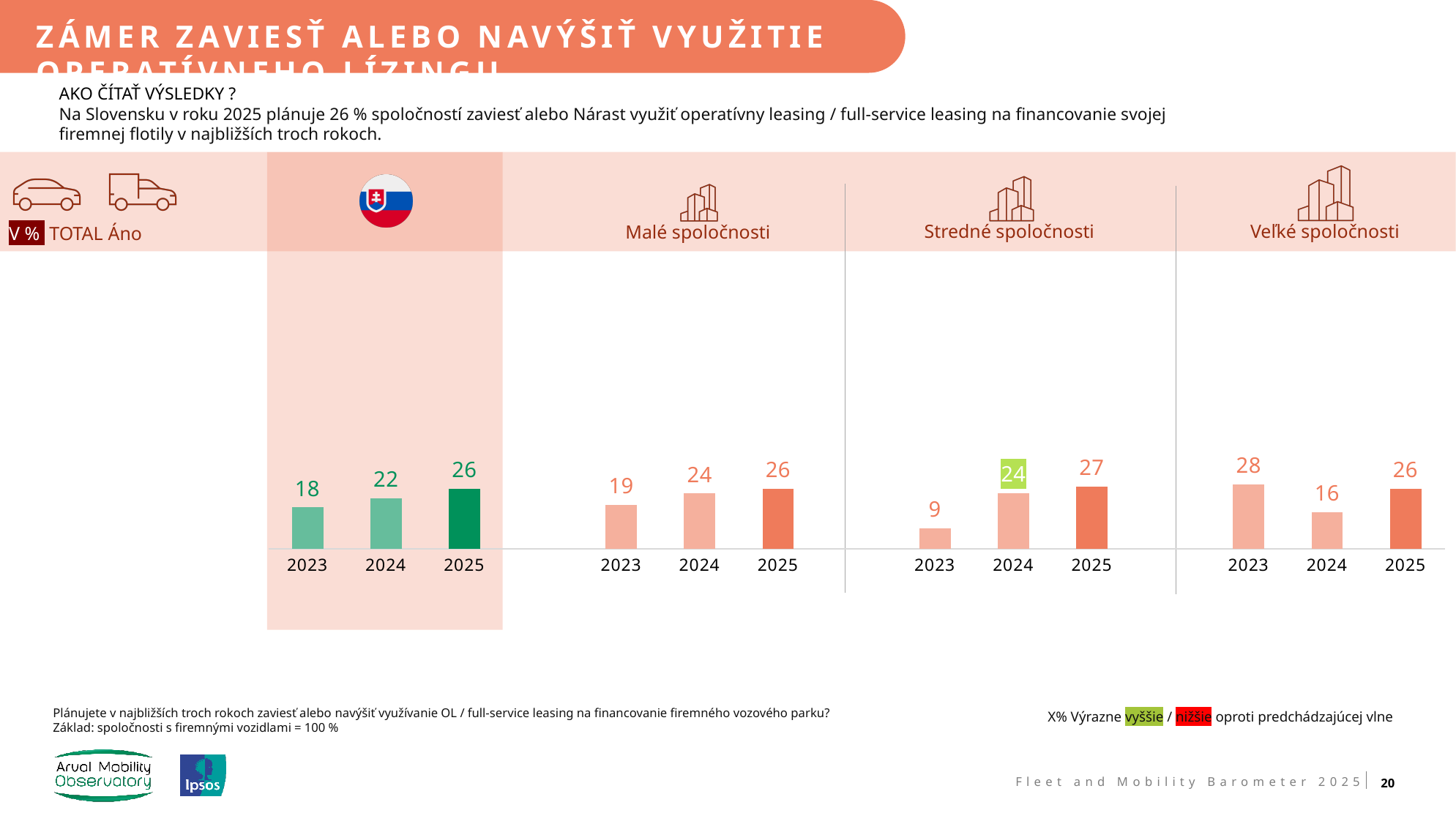
In the Stredné spoločnosti chart, what is the value for 2023? 9 In the Slovakia total chart (under the flag), what is the value for 2025? 26 In the Stredné spoločnosti chart, which year has the lowest value? 2023 In the Veľké spoločnosti chart, what is the value for 2024? 16 In the Slovakia total chart (under the flag), do the values rise or fall from 2023 to 2025? rise Which is larger: the 2025 value for Stredné spoločnosti or the 2025 value for Veľké spoločnosti? Stredné spoločnosti What type of chart is used for the Veľké spoločnosti data? bar chart How many years are shown in the Malé spoločnosti chart? 3 In the Stredné spoločnosti chart, what is the difference between the 2024 and 2023 values? 15 In the Malé spoločnosti chart, what is the value for 2023? 19 In the Slovakia total chart (under the flag), what is the difference between the 2025 and 2023 values? 8 In the Veľké spoločnosti chart, which year has the highest value? 2023